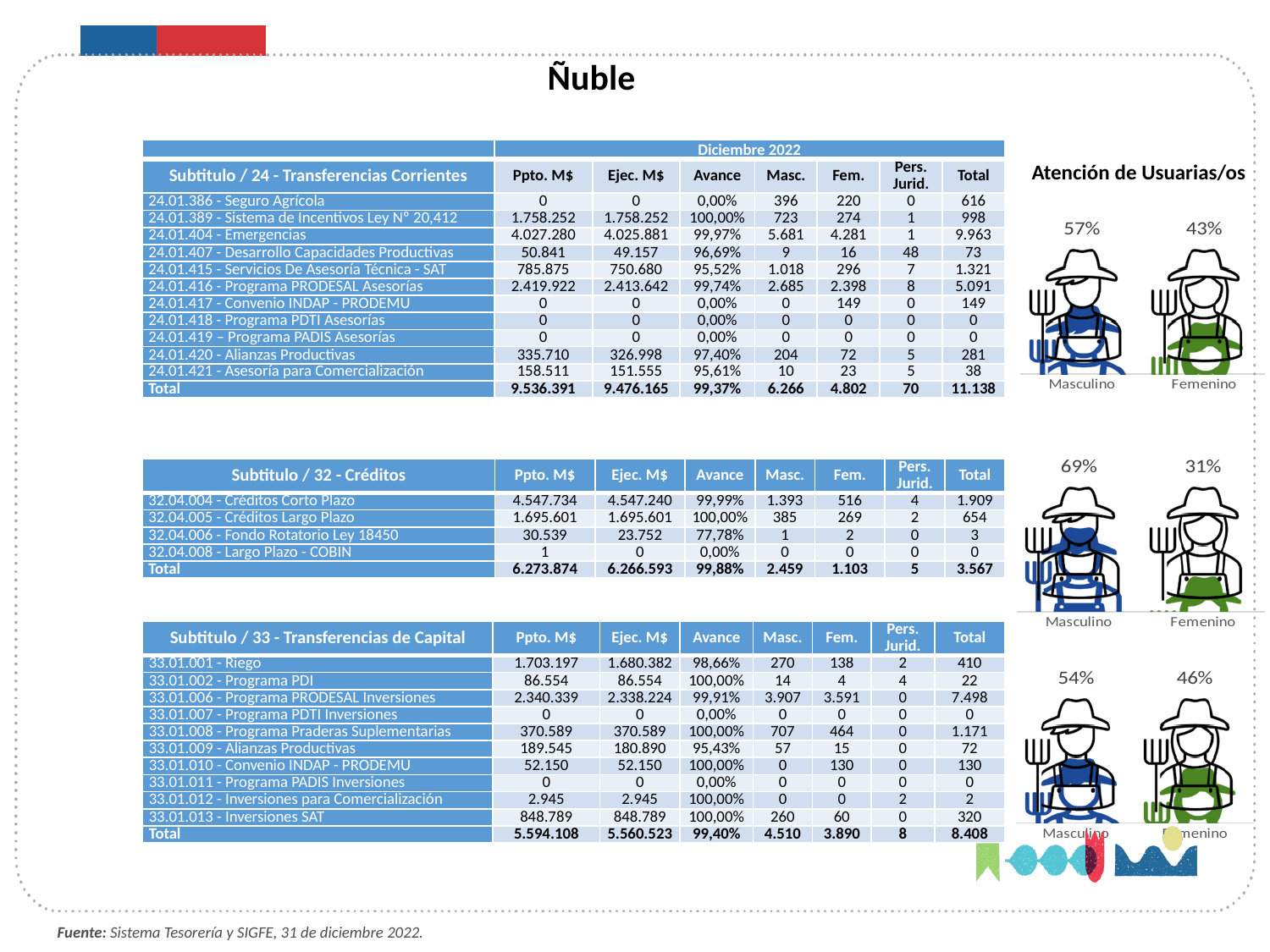
In the middle pictogram chart on the right side of the slide, what percentage is shown for Femenino? 31% In the middle pictogram chart on the right side of the slide, what is the difference in percentage points between Masculino and Femenino? 38 How many categories does each 'Atención de Usuarias/os' pictogram chart show? 2 In the top 'Atención de Usuarias/os' pictogram chart, what percentage is shown for Masculino? 57% In the middle pictogram chart on the right side of the slide, which category has the higher percentage, Masculino or Femenino? Masculino In the top 'Atención de Usuarias/os' pictogram chart, what is the difference in percentage points between Masculino and Femenino? 14 In the bottom pictogram chart on the right side of the slide, what percentage is shown for Femenino? 46% In the top 'Atención de Usuarias/os' pictogram chart, what percentage is shown for Femenino? 43% In the middle pictogram chart on the right side of the slide, what percentage is shown for Masculino? 69% In the bottom pictogram chart on the right side of the slide, what is the difference in percentage points between Masculino and Femenino? 8 What is the title above the pictogram charts on the right side of the slide? Atención de Usuarias/os In the bottom pictogram chart on the right side of the slide, what percentage is shown for Masculino? 54%